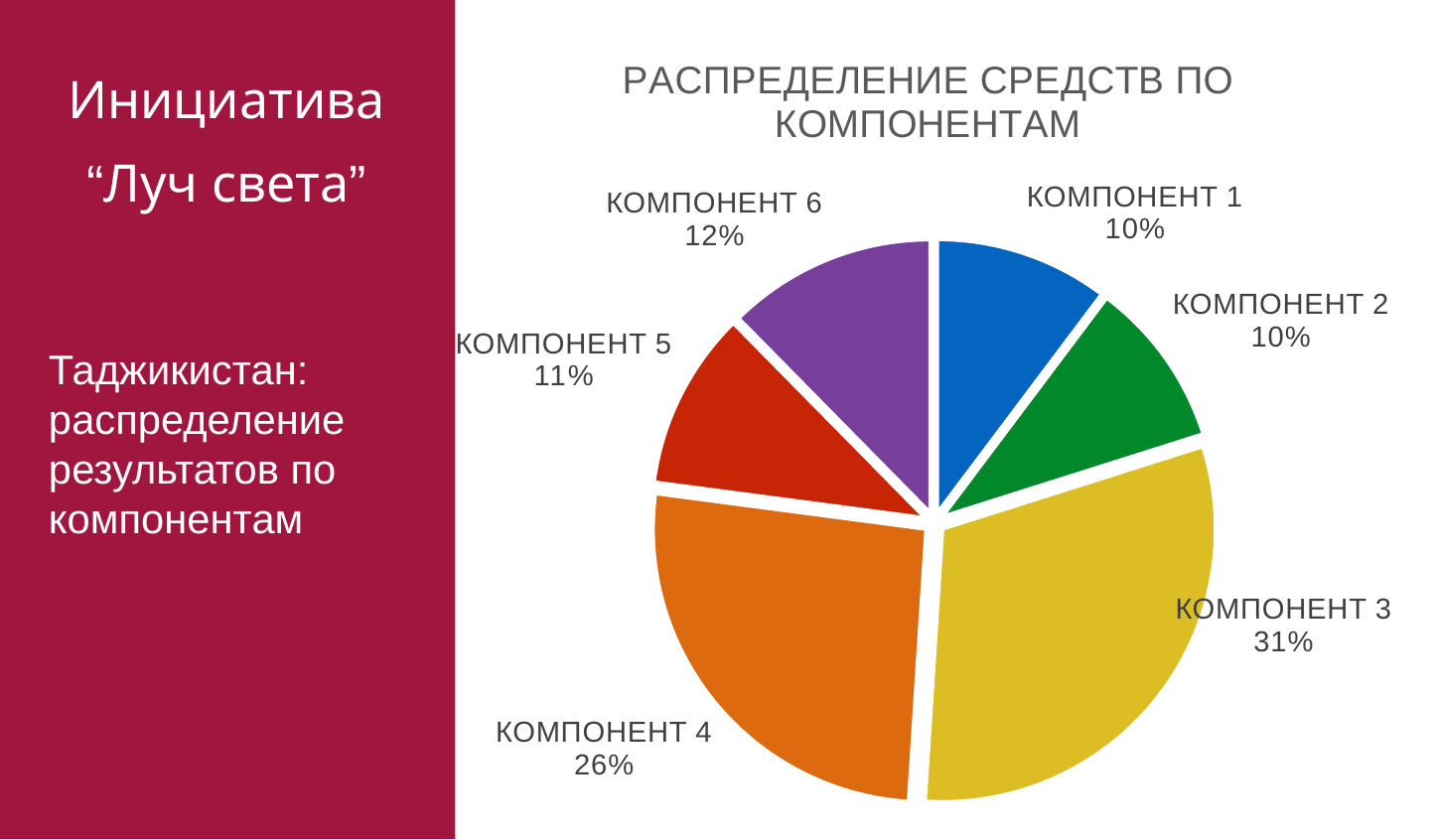
What is the difference in percentage points between КОМПОНЕНТ 6 and КОМПОНЕНТ 1? 2 What is the value shown for КОМПОНЕНТ 5? 11% Which is larger, the share of КОМПОНЕНТ 4 or КОМПОНЕНТ 3? КОМПОНЕНТ 3 What is the difference in percentage points between КОМПОНЕНТ 3 and КОМПОНЕНТ 4? 5 What colour is the slice for КОМПОНЕНТ 3? Yellow How many components (slices) does the pie chart show? 6 What kind of chart is shown on the slide? Pie chart What is the title of the chart? РАСПРЕДЕЛЕНИЕ СРЕДСТВ ПО КОМПОНЕНТАМ What share of the pie does КОМПОНЕНТ 3 have? 31% What is the value shown for КОМПОНЕНТ 6? 12% What is the value shown for КОМПОНЕНТ 4? 26% Which component has the largest share of the pie? КОМПОНЕНТ 3